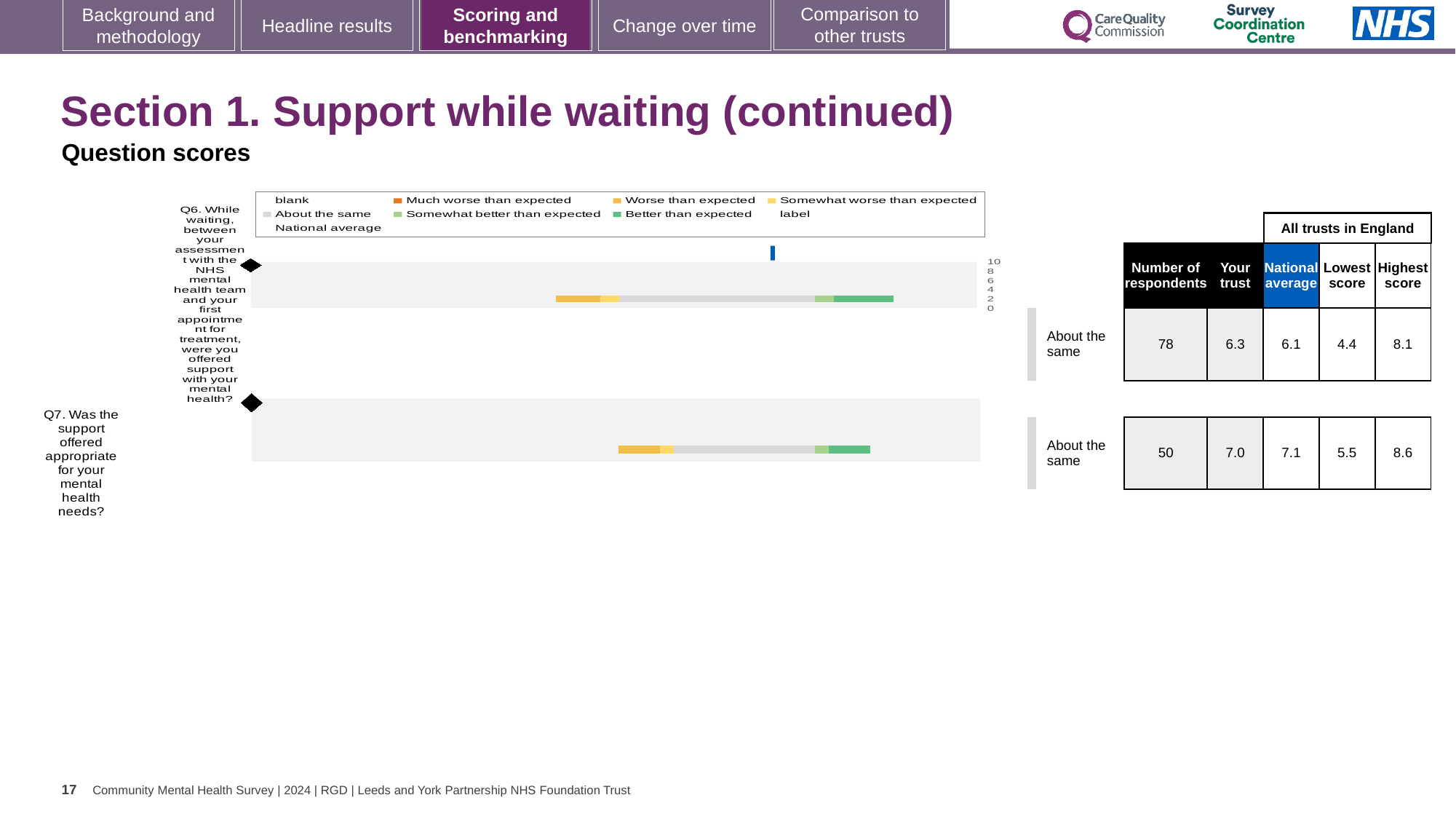
What is the difference between the highest score and the lowest score for Q7? 3.1 What is the lowest score among all trusts in England for Q6? 4.4 What is the national average score for Q7 shown beside the chart? 7.1 What is the 'Your trust' score for Q6 shown beside the chart? 6.3 How many questions (bars) are plotted in the chart? 2 How many entries does the chart legend list? 9 What kind of chart is shown on the slide? bar chart Which question has the higher 'Your trust' score, Q6 or Q7? Q7 What benchmark rating is given for Q6? About the same How many respondents answered Q6? 78 What colour represents 'Much worse than expected' in the chart legend? orange What colour represents 'Better than expected' in the chart legend? green